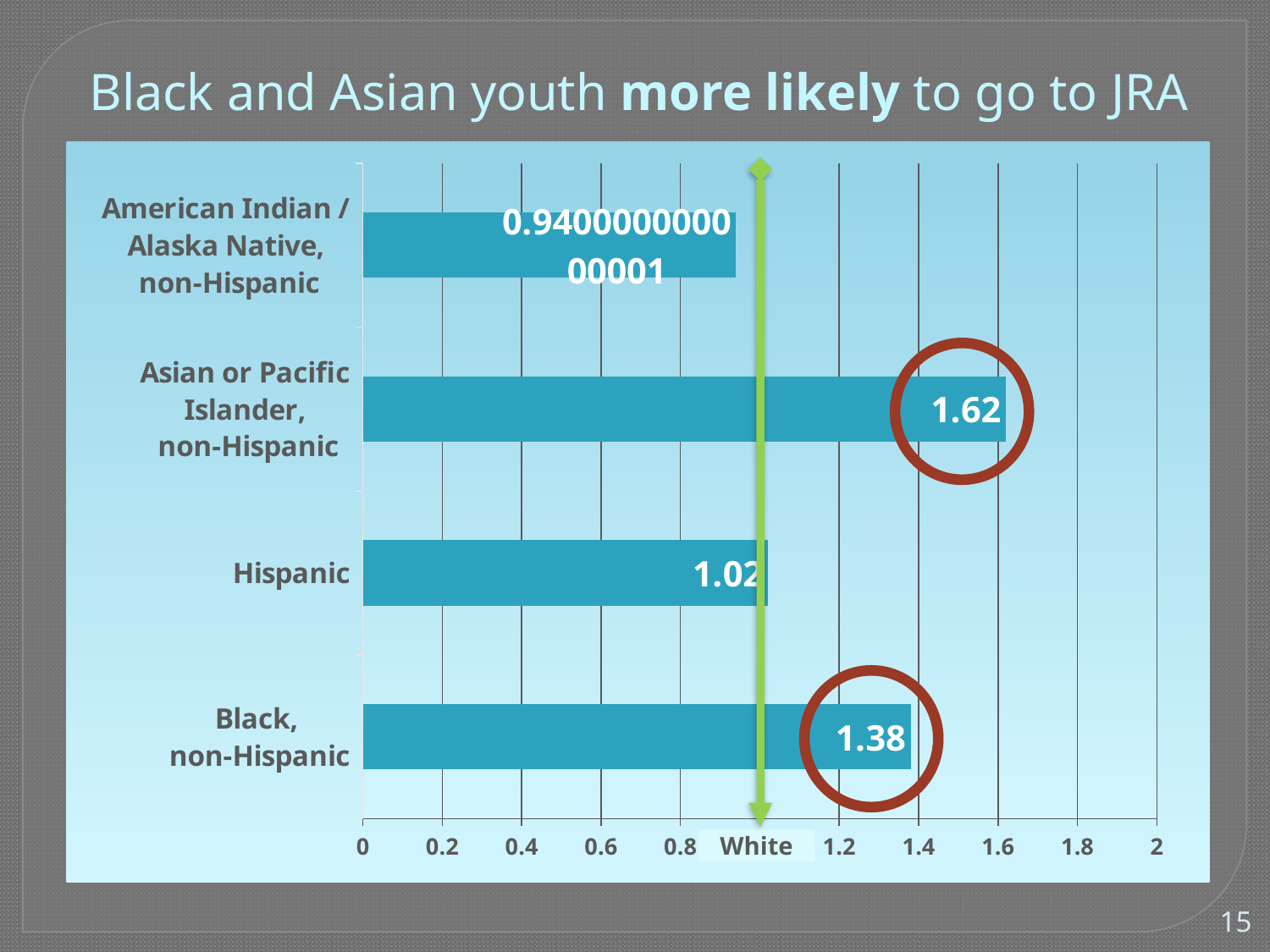
What is the difference between the values for Asian or Pacific Islander, non-Hispanic and Black, non-Hispanic? 0.24 What is the value for Asian or Pacific Islander, non-Hispanic? 1.62 Which is larger, the value for Black, non-Hispanic or the value for Hispanic? Black, non-Hispanic Which category has the lowest value? American Indian / Alaska Native, non-Hispanic What type of chart is shown on the slide? bar chart What is the value for Black, non-Hispanic? 1.38 Is the value for American Indian / Alaska Native, non-Hispanic greater or less than 1? less Which category has the highest value? Asian or Pacific Islander, non-Hispanic What is the value for Hispanic? 1.02 What label appears on the x axis where the green vertical reference line crosses it? White How many categories are plotted in the chart? 4 What is the value for American Indian / Alaska Native, non-Hispanic? 0.940000000000001